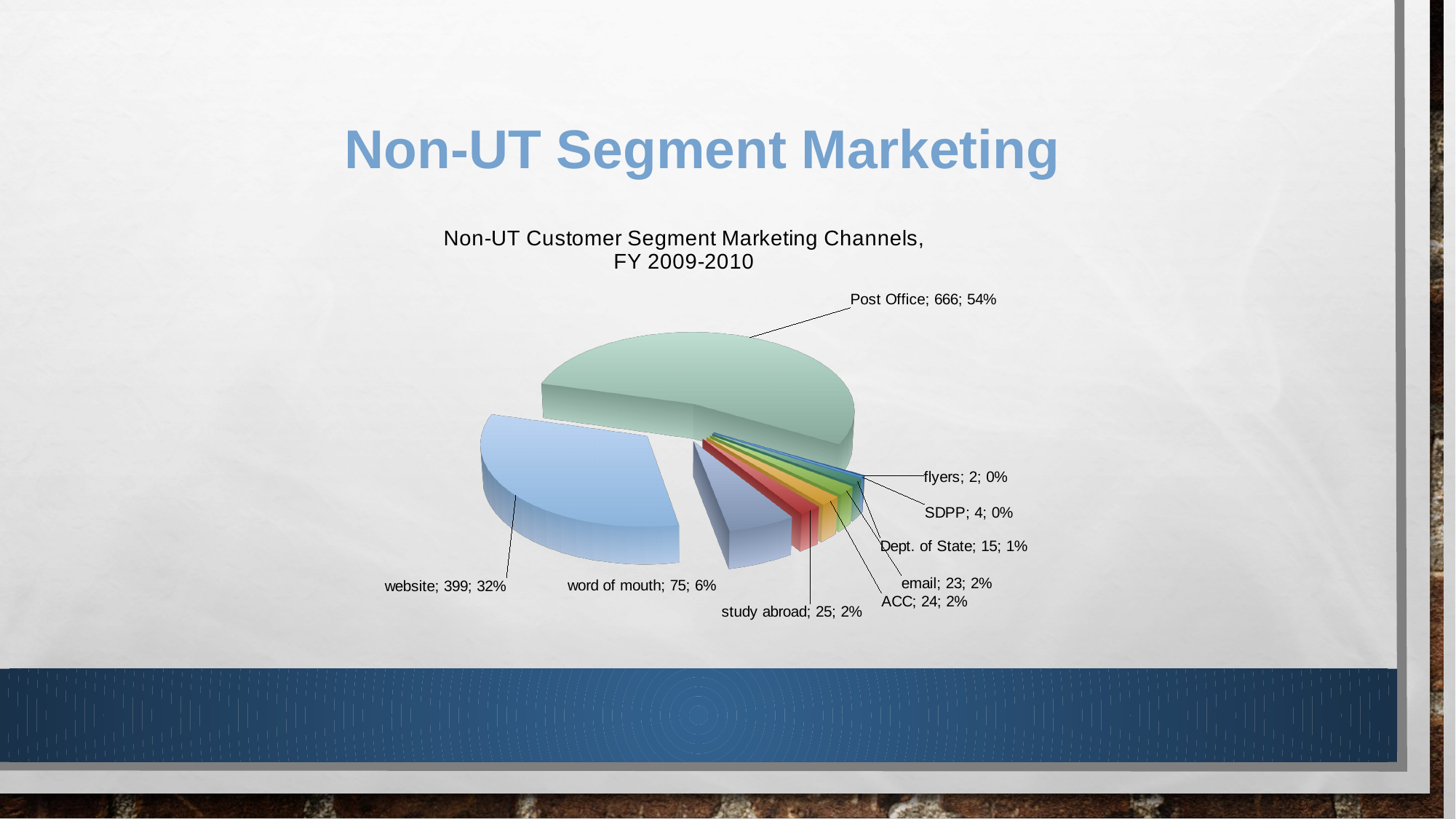
Which category has the smallest slice? flyers What is the value for website? 399 How many categories (slices) does the pie chart have? 9 What share of the pie does website represent? 32% What share of the pie does Post Office represent? 54% Which is larger, the value for ACC or the value for email? ACC What is the value for Post Office? 666 What is the title of the chart? Non-UT Customer Segment Marketing Channels, FY 2009-2010 What is the value for word of mouth? 75 What is the difference between the values for Post Office and website? 267 Which category has the largest slice? Post Office What kind of chart is shown on the slide? Pie chart